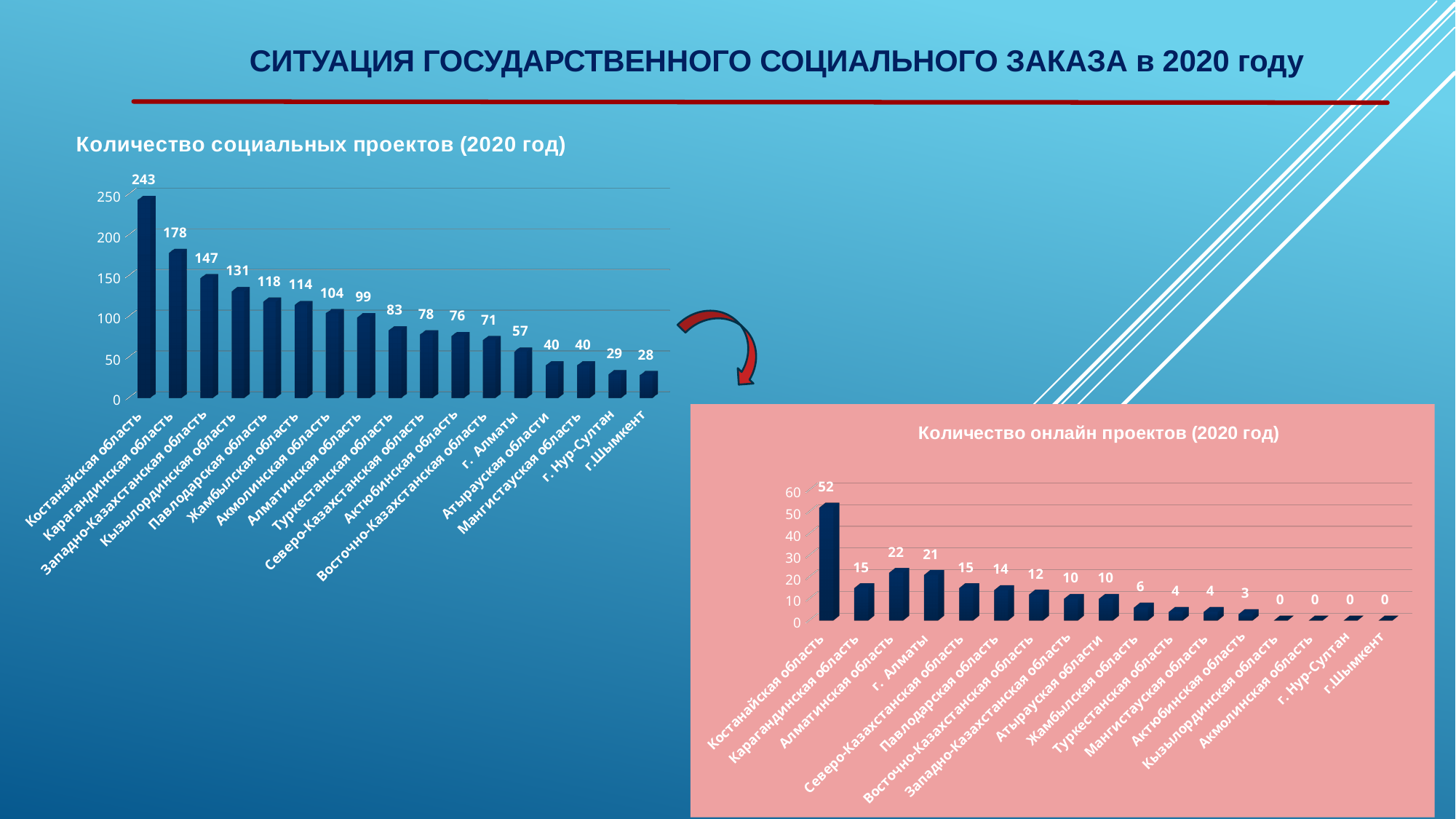
In the chart 'Количество онлайн проектов (2020 год)', what is the value for Алматинская область? 22 In the chart 'Количество онлайн проектов (2020 год)', how many categories have a value of 0? 4 In the chart 'Количество социальных проектов (2020 год)', what is the value for Карагандинская область? 178 In the chart 'Количество социальных проектов (2020 год)', what is the difference between Костанайская область and Карагандинская область? 65 In the chart 'Количество онлайн проектов (2020 год)', which region has the highest value? Костанайская область In the chart 'Количество онлайн проектов (2020 год)', which is larger: г. Алматы or Карагандинская область? г. Алматы In the chart 'Количество социальных проектов (2020 год)', which region has the highest value? Костанайская область In the chart 'Количество социальных проектов (2020 год)', do the values rise or fall from left to right? Fall What type of chart is 'Количество социальных проектов (2020 год)'? Bar chart In the chart 'Количество социальных проектов (2020 год)', how many categories are shown? 17 In the chart 'Количество социальных проектов (2020 год)', which category has the lowest value? г.Шымкент In the chart 'Количество онлайн проектов (2020 год)', what is the difference between Костанайская область and Алматинская область? 30